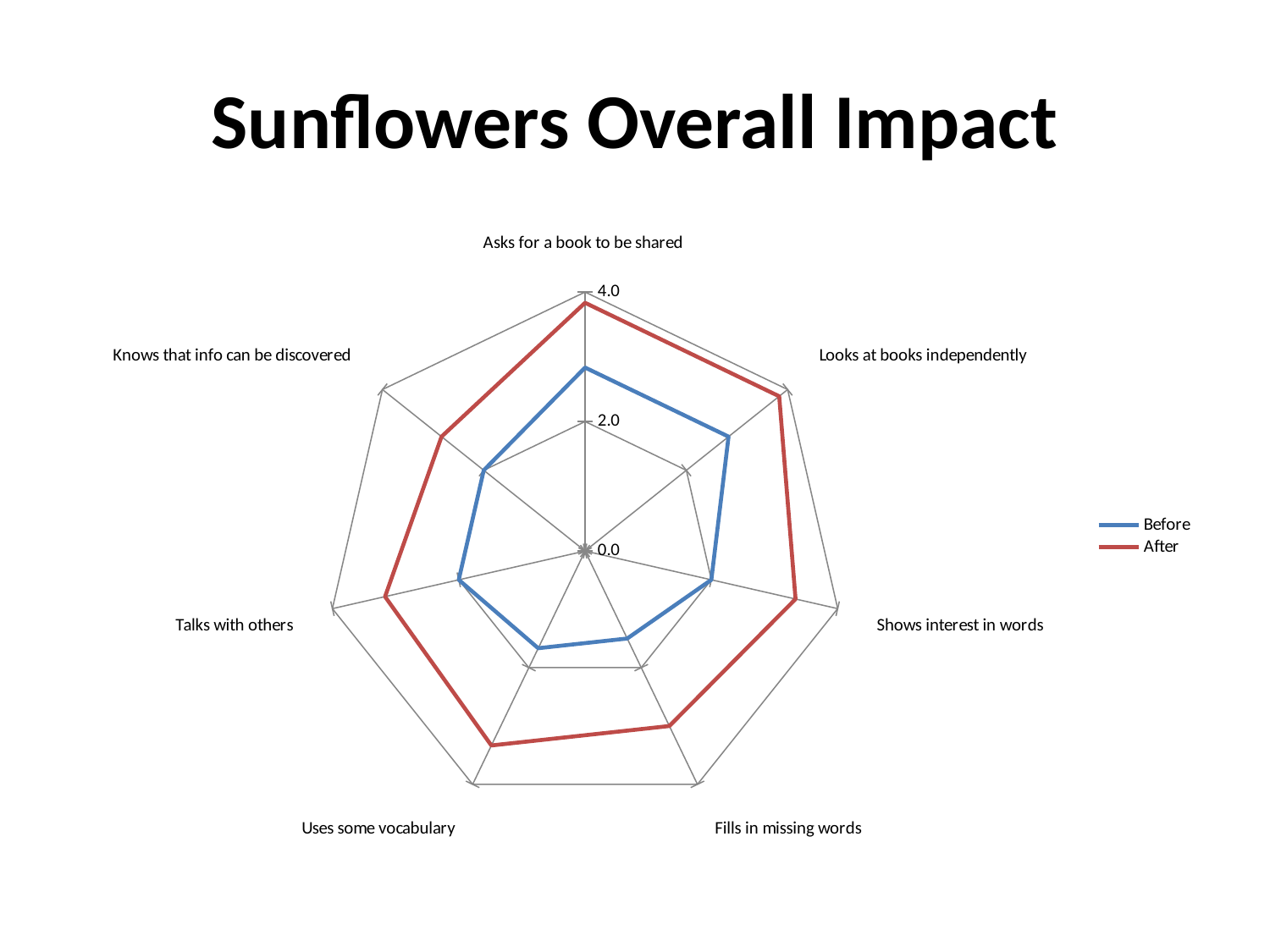
Is the After value for "Shows interest in words" greater or less than 4.0? less How many series does the legend list? 2 Is the Before value for "Fills in missing words" greater or less than 2.0? less What are the two series named in the legend? Before and After Is the Before value for "Uses some vocabulary" greater or less than 2.0? less For "Knows that info can be discovered", which series has the larger value, Before or After? After How many categories (axes) does the radar chart have? 7 For "Talks with others", which series has the larger value, Before or After? After What is the title of the slide? Sunflowers Overall Impact What kind of chart is shown on the slide? Radar chart